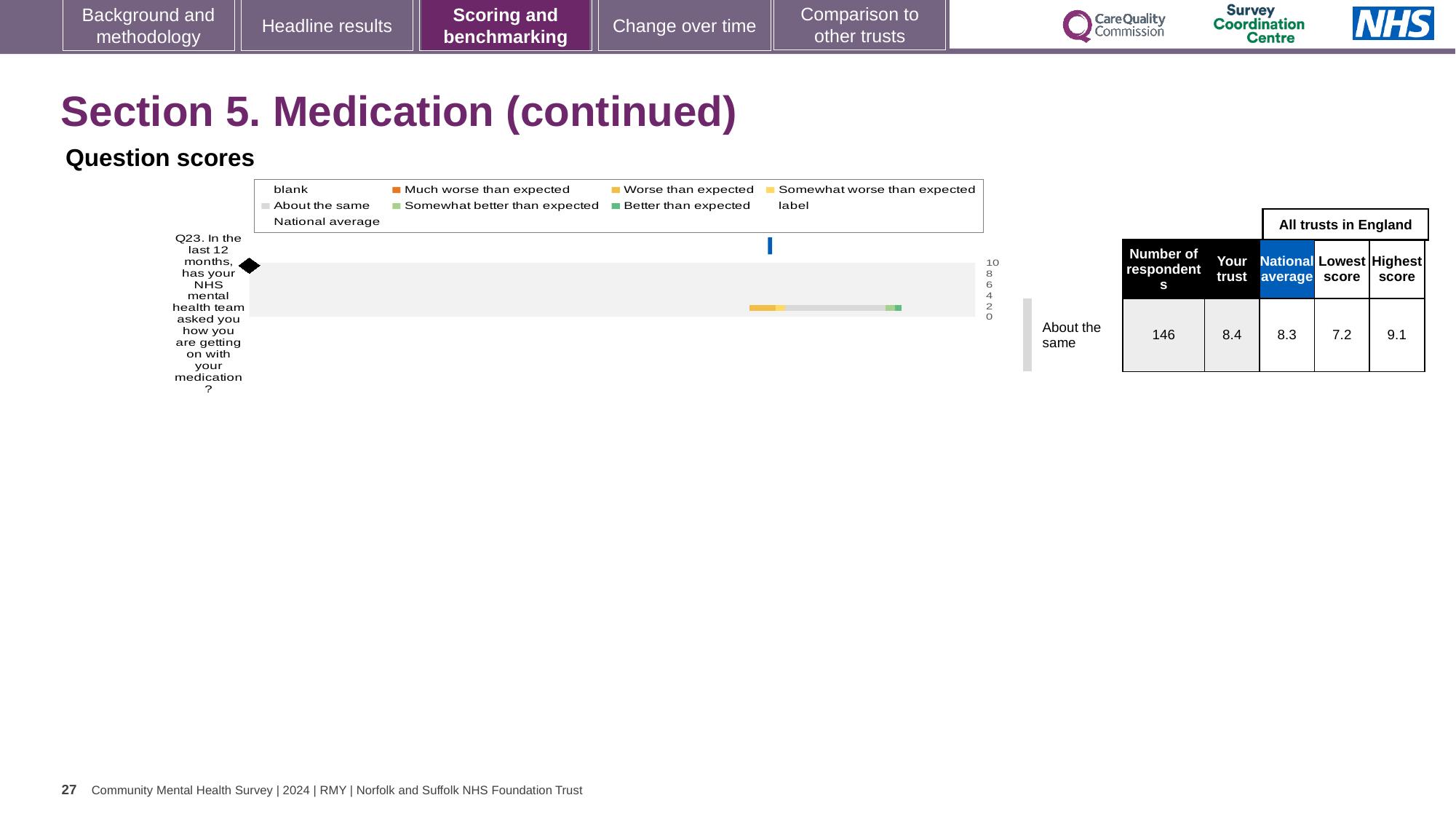
Which is larger for Q23, the 'Your trust' score or the national average? Your trust What is the highest value shown on the chart's axis? 10 What is the national average score for Q23? 8.3 What is the highest score among all trusts in England for Q23? 9.1 Which legend entry is shown in orange? Much worse than expected What benchmark category is Q23 assigned to? About the same How many survey questions are plotted in the chart? 1 What is the lowest score among all trusts in England for Q23? 7.2 What kind of chart is shown under 'Question scores'? bar chart How many respondents answered Q23? 146 What is the 'Your trust' score for Q23? 8.4 What is the difference between the highest and lowest trust scores for Q23? 1.9